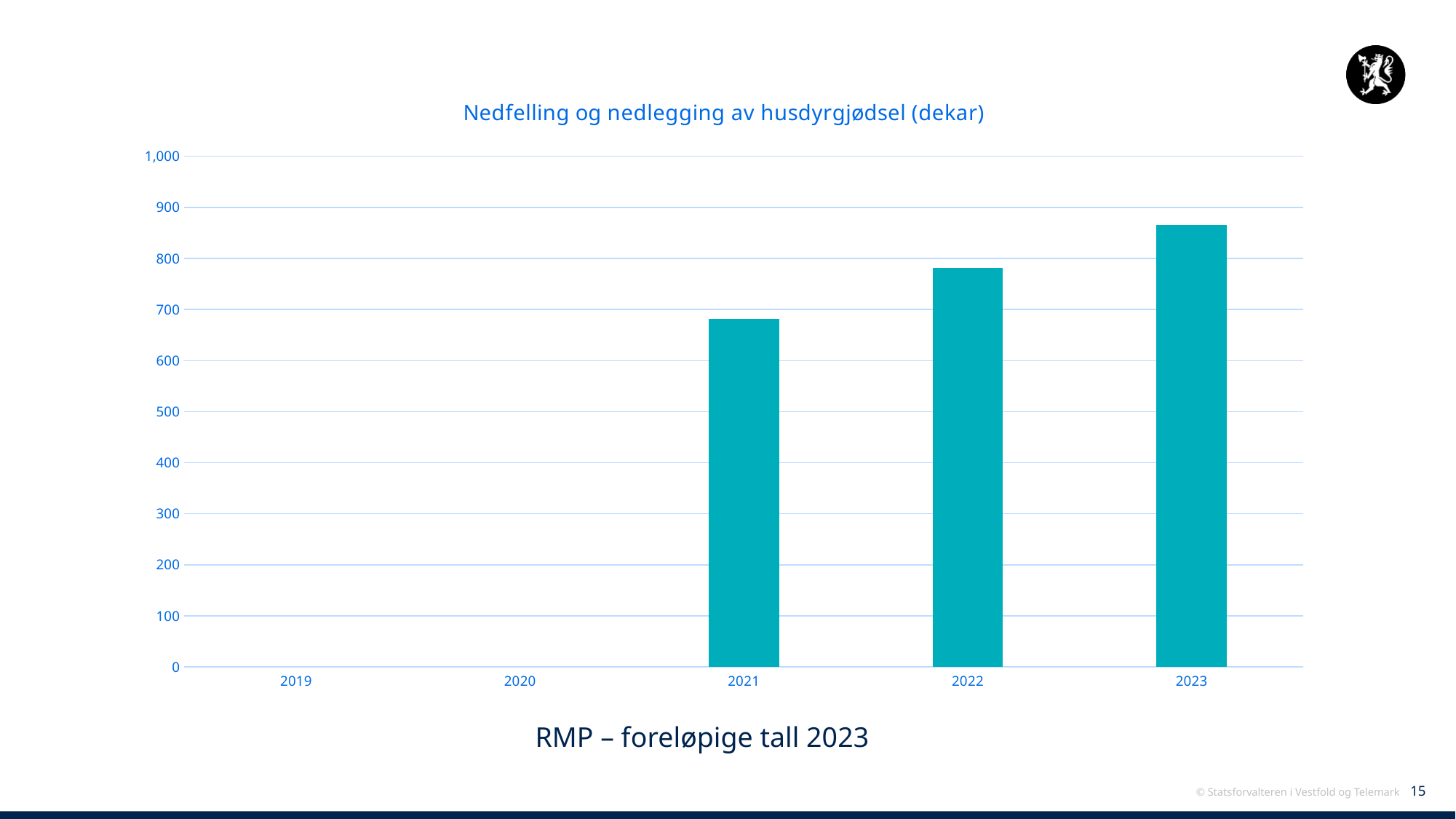
Which of the years with a visible bar has the shortest bar? 2021 Is the value for 2022 greater or less than 700? greater Is the value for 2021 greater or less than 600? greater Is the value for 2023 greater or less than 800? greater Which year has the tallest bar in the chart? 2023 How many years are labelled on the x axis of the chart? 5 Do the bar values rise or fall from 2021 to 2023? rise What is the title of the chart? Nedfelling og nedlegging av husdyrgjødsel (dekar) Which is larger, the value for 2022 or the value for 2021? 2022 What kind of chart is shown on the slide? bar chart